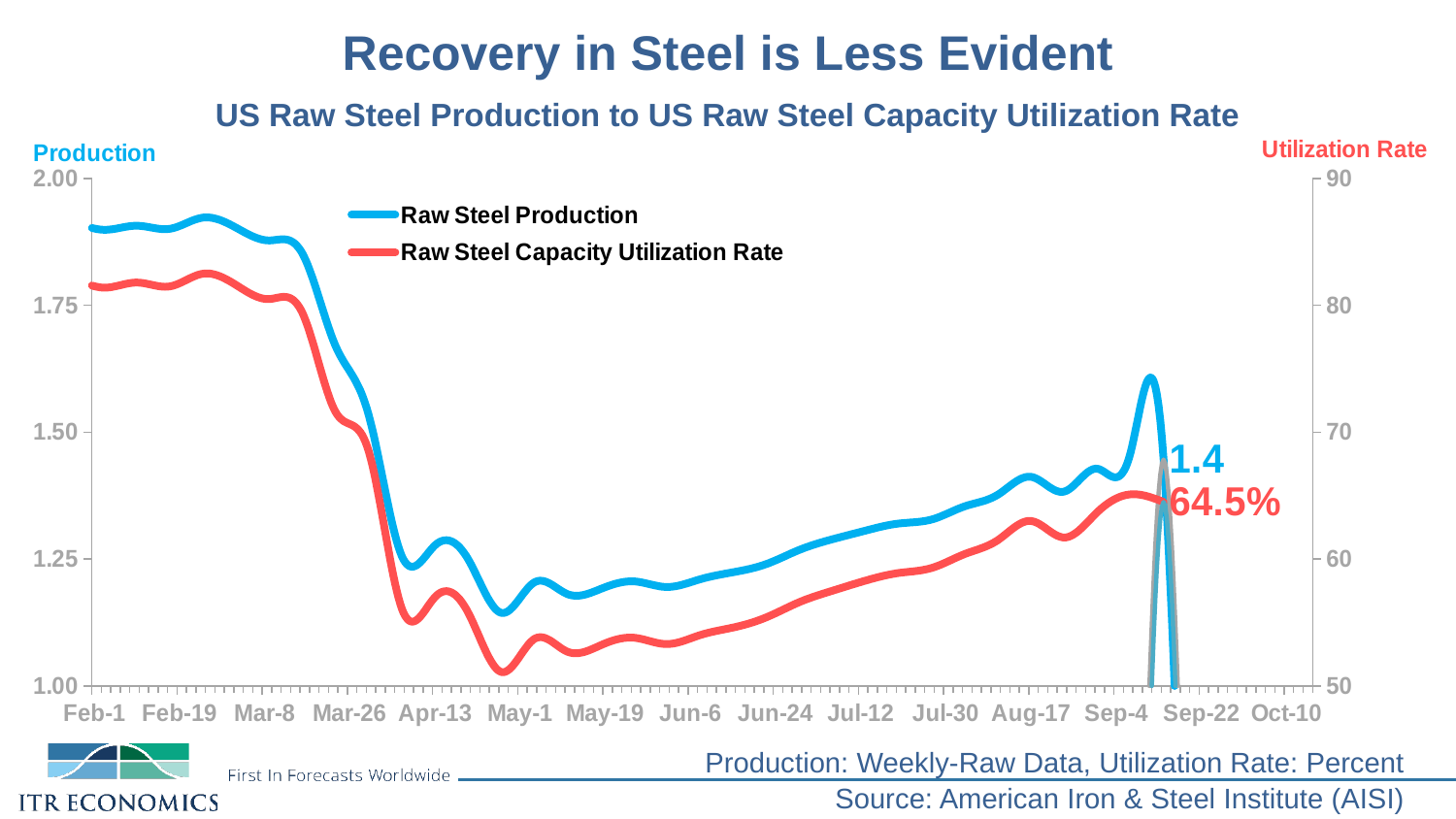
How many series does the legend list? 2 Is the Raw Steel Production value at Feb-1 greater or less than 1.75? greater What colour is the Raw Steel Capacity Utilization Rate line? red What is the labeled final value of Raw Steel Production? 1.4 Does Raw Steel Production rise or fall between Feb-1 and May-1? fall Around which x-axis label is Raw Steel Production at its lowest? May-1 How many date labels are shown on the x axis? 15 What type of chart is shown on the slide? line chart What is the labeled final value of the Raw Steel Capacity Utilization Rate? 64.5% Is the Raw Steel Capacity Utilization Rate at Aug-17 greater or less than 60? greater Is the Raw Steel Capacity Utilization Rate at May-1 greater or less than 60? less